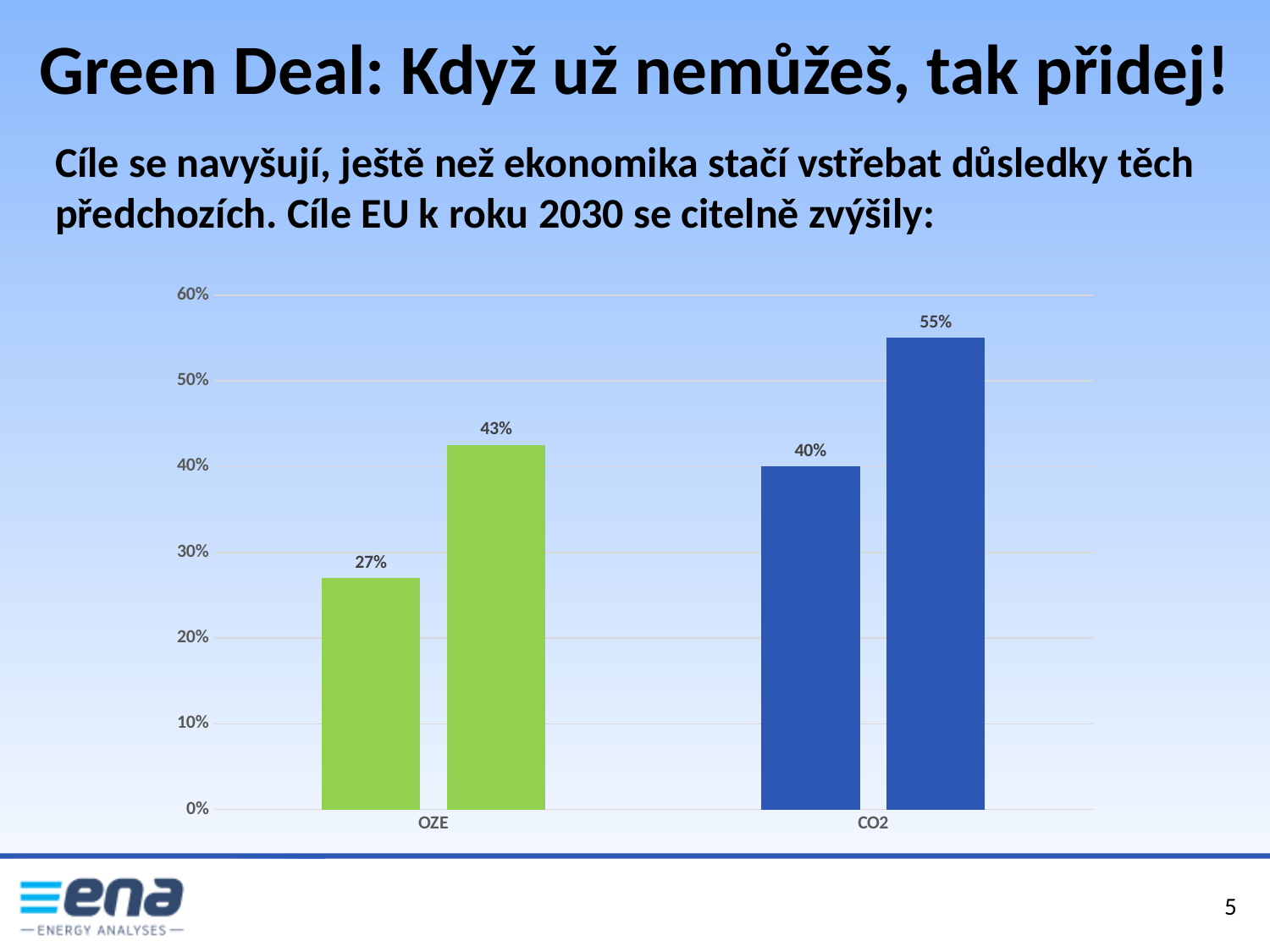
What is the value of the right (second) bar for OZE? 43% How many categories are shown on the x axis? 2 What is the value of the left (first) bar for OZE? 27% Which is larger: the right bar for OZE or the left bar for CO2? The right bar for OZE (43%) What is the difference between the two OZE bars? 16 percentage points Which bar in the chart has the highest value? The right bar for CO2 (55%) Which bar in the chart has the lowest value? The left bar for OZE (27%) What kind of chart is shown on the slide? Bar chart What colour are the bars for the CO2 category? Blue What is the value of the left (first) bar for CO2? 40% What is the difference between the two CO2 bars? 15 percentage points What is the value of the right (second) bar for CO2? 55%